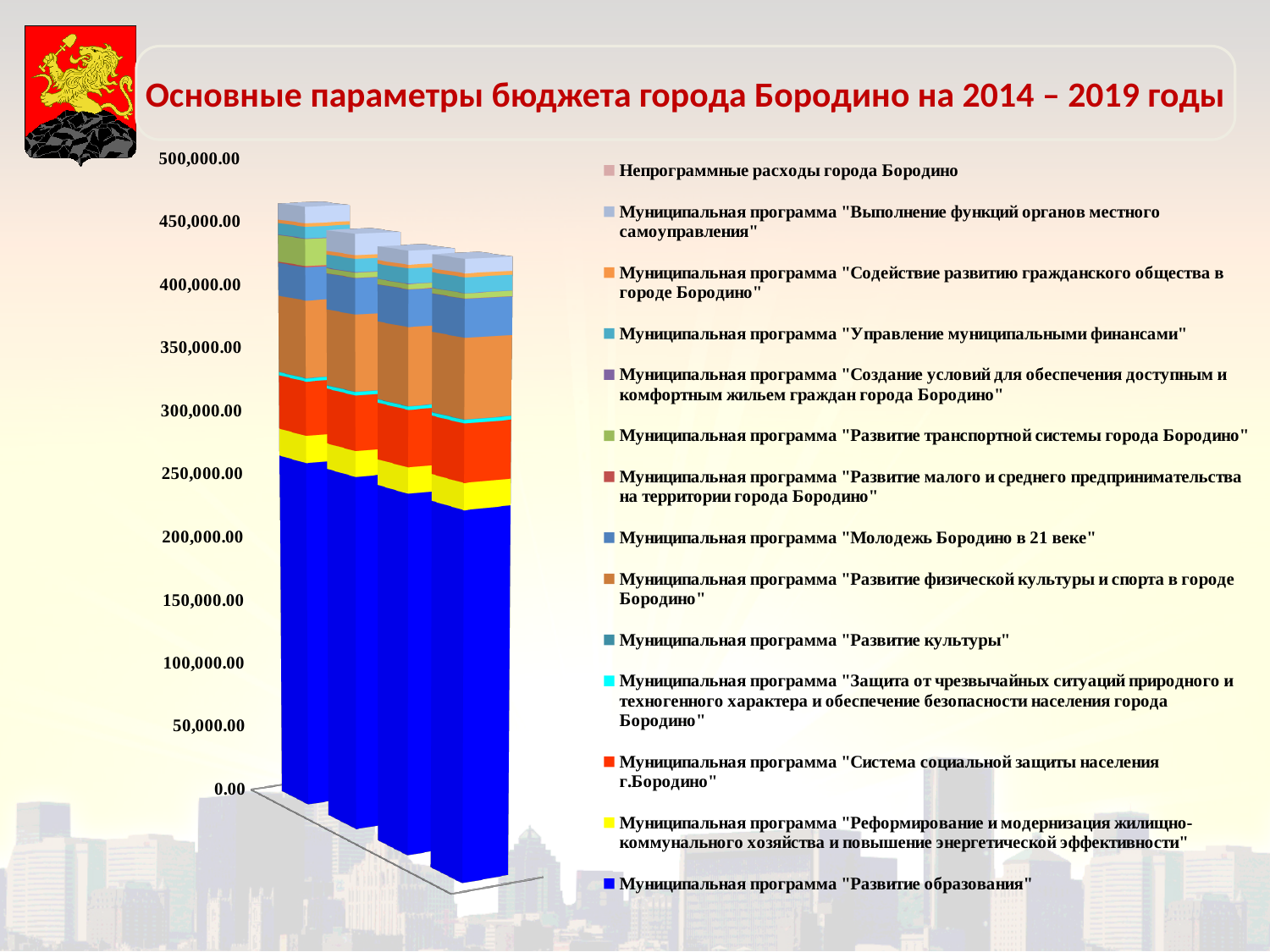
Which bar has the largest total? the leftmost bar Which bar has the greatest total height, the leftmost or the rightmost? leftmost Do the bar totals rise or fall from left to right? fall How many bars are plotted in the chart? 4 What kind of chart is shown on the slide? stacked bar chart Is the total of the rightmost bar greater or less than 400,000.00? greater How many series does the chart legend list? 14 Is the total of the leftmost bar greater or less than 450,000.00? greater Which colour represents the series "Муниципальная программа "Развитие образования"" in the legend? blue What is the highest value shown on the vertical axis? 500,000.00 Is the total of the rightmost bar greater or less than 450,000.00? less